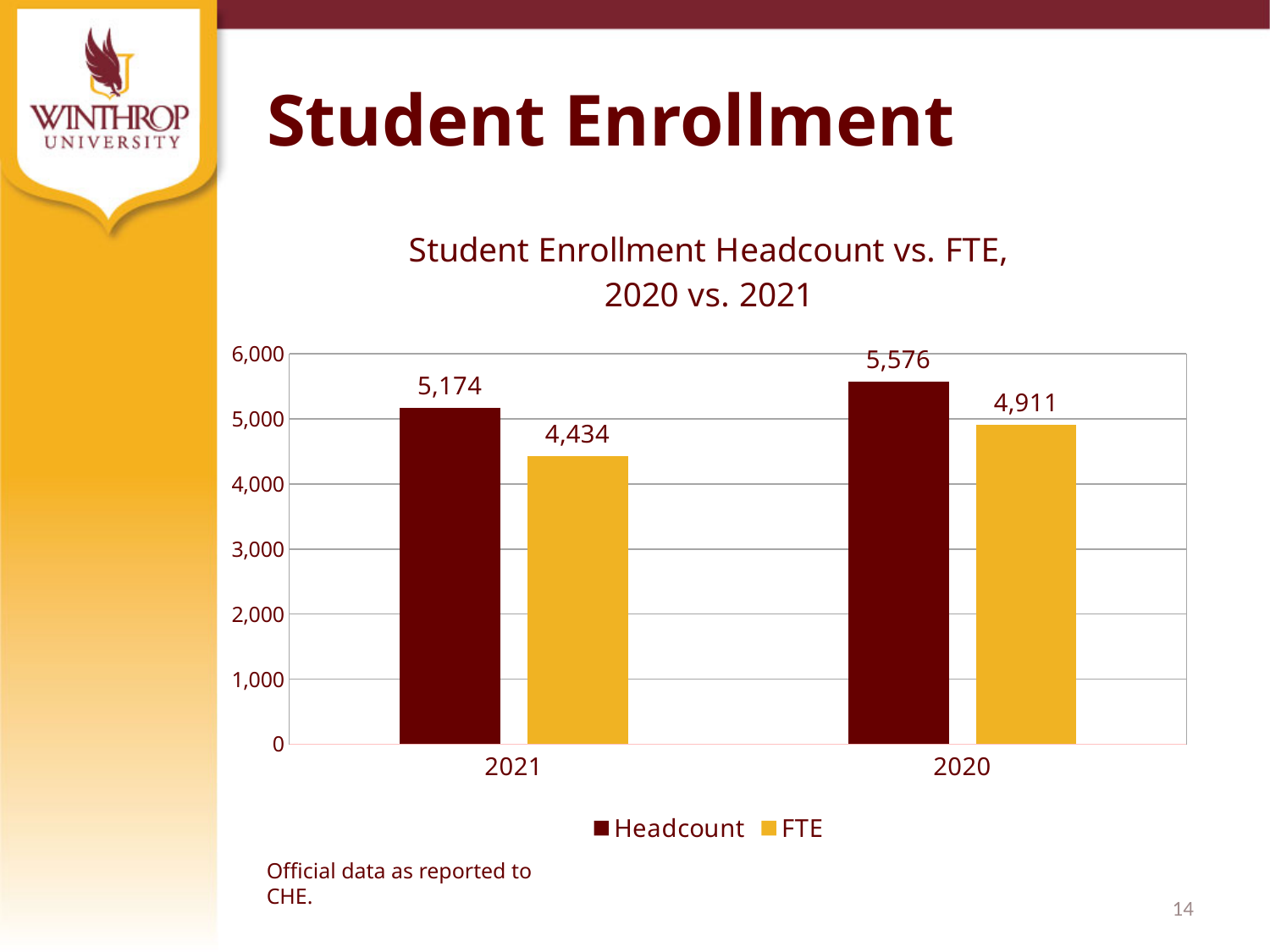
Is the Headcount value for 2020 greater or less than 5,000? greater What kind of chart is shown on the slide? bar chart Which year has the higher Headcount? 2020 Which bar shows the lowest value on the chart? FTE for 2021 How many series does the legend list? 2 What is the Headcount value for 2021? 5,174 What is the FTE value for 2020? 4,911 By how much did the Headcount change from 2020 to 2021? 402 What is the title of the chart? Student Enrollment Headcount vs. FTE, 2020 vs. 2021 What is the difference between the Headcount and FTE values for 2020? 665 Is the FTE for 2021 larger or smaller than the FTE for 2020? smaller What is the FTE value for 2021? 4,434